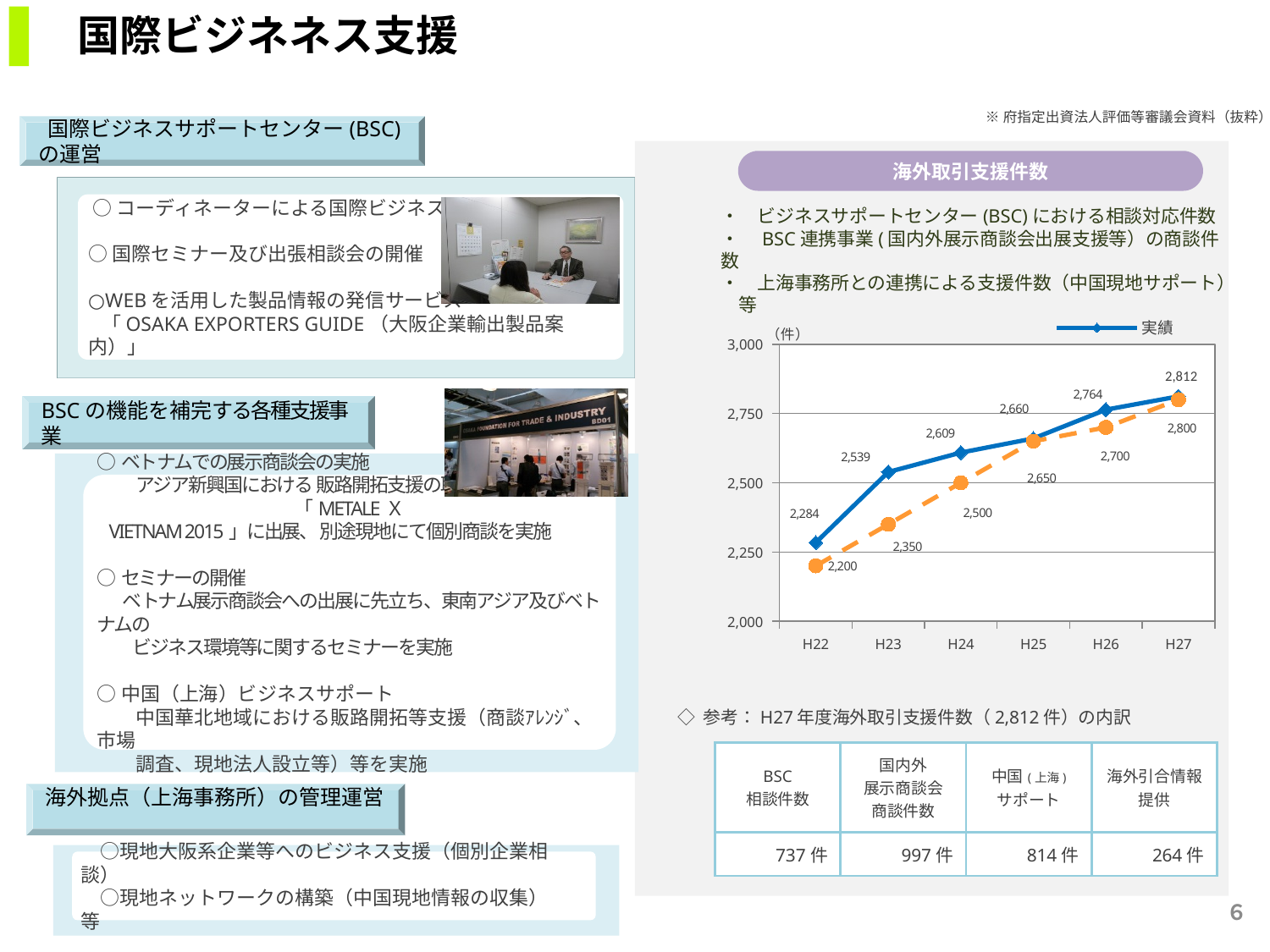
In the 海外取引支援件数 chart, what is the 実績 value for H27? 2,812 In the 海外取引支援件数 chart, which year has the highest 実績 value? H27 In the 海外取引支援件数 chart, which is larger, the 実績 value for H24 or for H26? H26 How many years are shown on the x axis of the 海外取引支援件数 chart? 6 In the 海外取引支援件数 chart, what is the 実績 value for H22? 2,284 In the 海外取引支援件数 chart, which year has the lowest 実績 value? H22 How many series does the legend of the 海外取引支援件数 chart list? 1 In the 海外取引支援件数 chart, does the 実績 line rise or fall from H22 to H27? rises In the 海外取引支援件数 chart, what is the difference between the 実績 values for H27 and H22? 528 What type of chart is shown under the heading 海外取引支援件数? line chart In the 海外取引支援件数 chart, what is the difference between the 実績 values for H23 and H22? 255 In the 海外取引支援件数 chart, what is the 実績 value for H25? 2,660